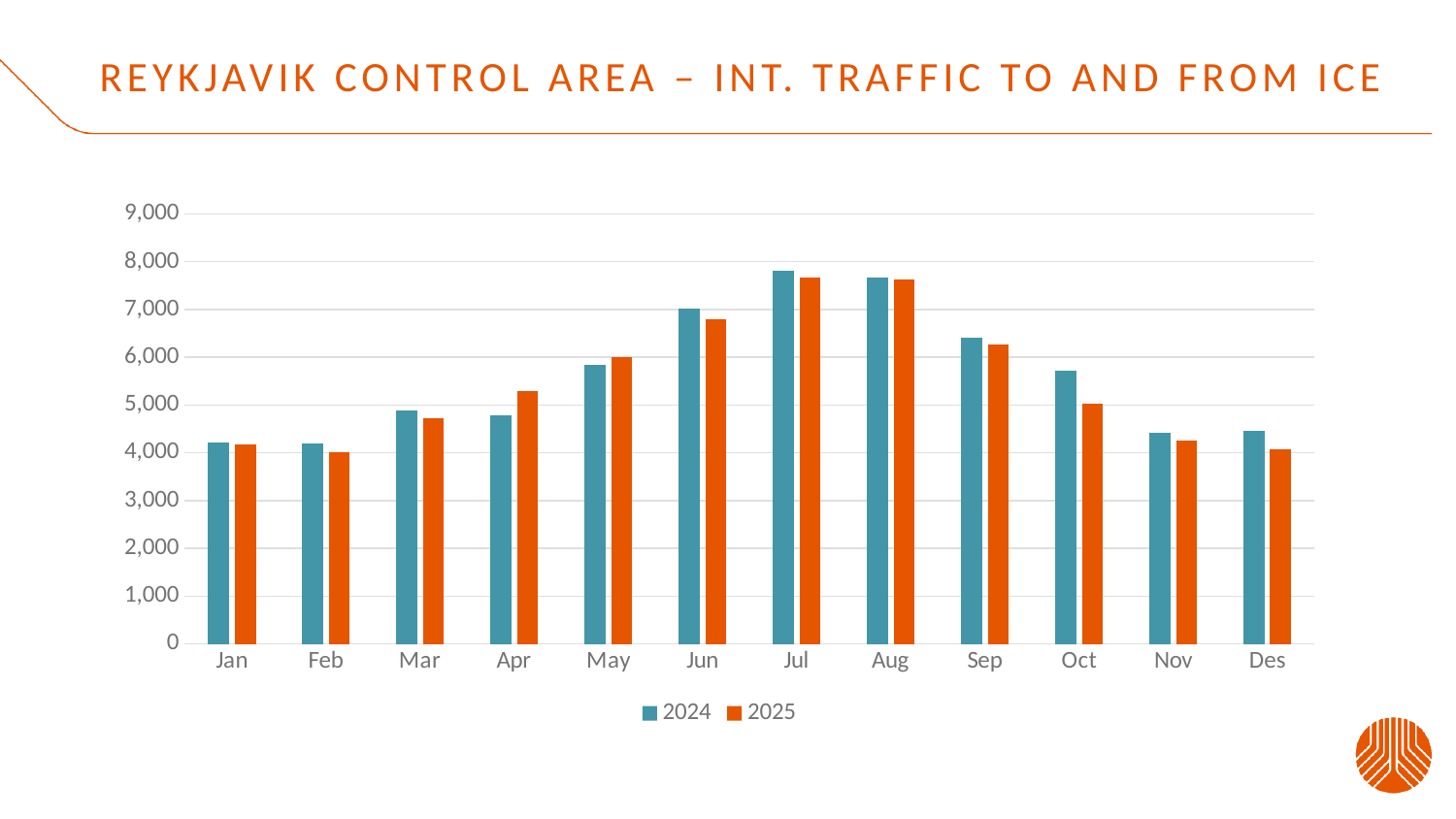
How many months are shown on the x axis? 12 In Oct, which series has the larger value, 2024 or 2025? 2024 Is the value for Feb 2025 greater or less than 5,000? less Is the value for Apr 2025 greater or less than 5,000? greater Is the value for Sep 2024 greater or less than 6,000? greater Do the 2024 values rise or fall from Jul to Des? fall What is the title of the chart on the slide? REYKJAVIK CONTROL AREA – INT. TRAFFIC TO AND FROM ICE What kind of chart is shown on the slide? bar chart In Apr, which series has the larger value, 2024 or 2025? 2025 How many series does the legend list? 2 Which month has the highest value for 2024? Jul